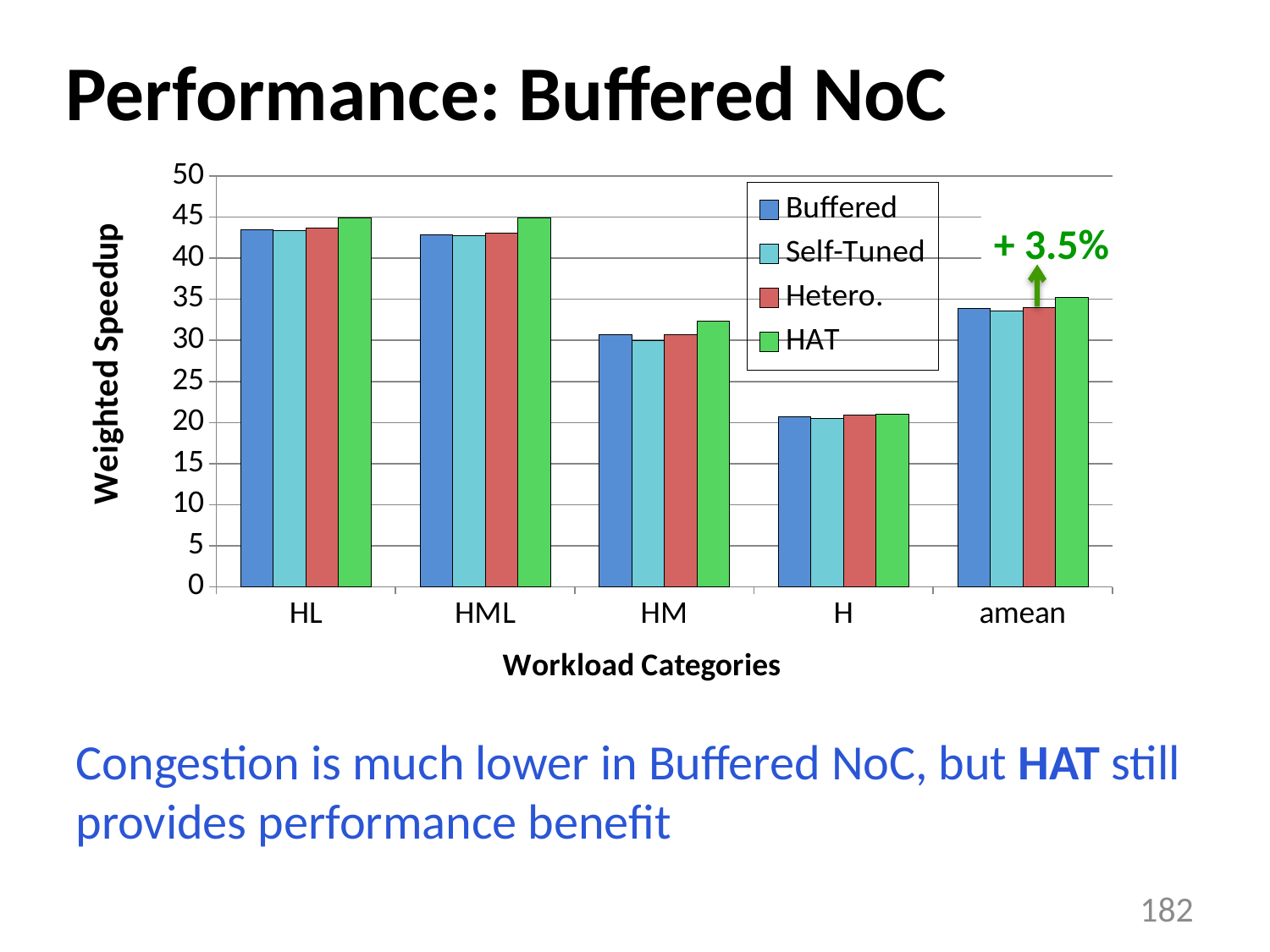
Is the weighted speedup for Buffered in the H category greater or less than 25? less Which has the larger weighted speedup for HAT: HL or H? HL What is the label of the y axis? Weighted Speedup What kind of chart is shown on the slide? bar chart What percentage improvement is annotated above the amean category? + 3.5% How many workload categories are shown on the x axis? 5 How many series does the legend list? 4 Is the weighted speedup for HAT in the amean category greater or less than 40? less Do the weighted speedup values rise or fall going from HL to H along the x axis? fall Is the weighted speedup for Buffered in the HL category greater or less than 40? greater Which workload category has the lowest weighted speedup? H